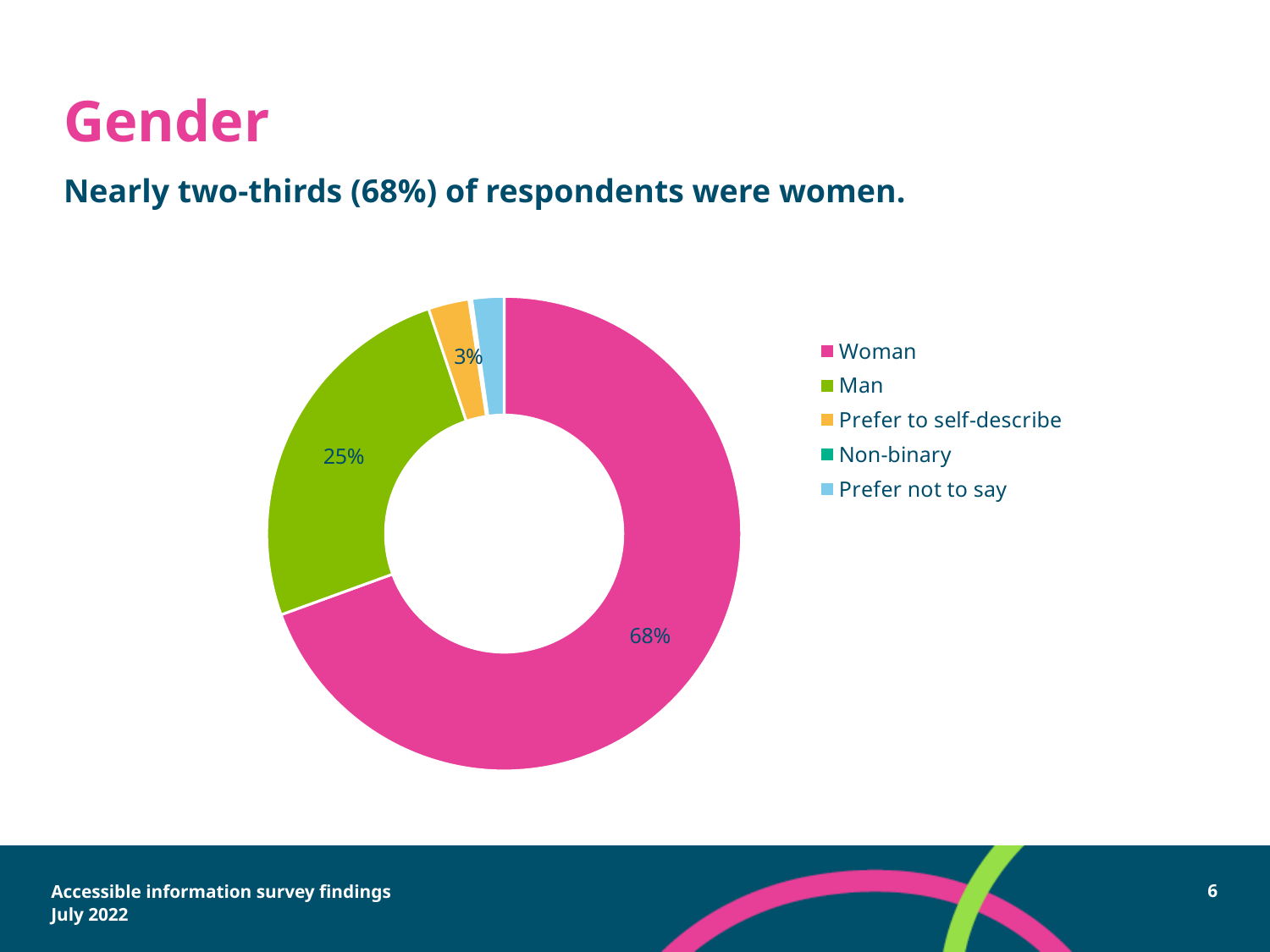
Which is larger: the share for Man or the share for Prefer to self-describe? Man What percentage of respondents chose 'Prefer to self-describe'? 3% What colour represents the Woman category in the chart? Pink What share of the pie does the Woman slice take up? 68% Is the share for Man greater or less than 50%? less How many categories does the chart legend list? 5 What percentage of respondents identified as a man? 25% What is the title of the slide containing the chart? Gender What percentage of respondents were women according to the chart? 68% How many percentage points larger is the Woman share than the Man share? 43 percentage points What kind of chart is shown on the slide? Pie (donut) chart Which gender category has the largest share of respondents? Woman